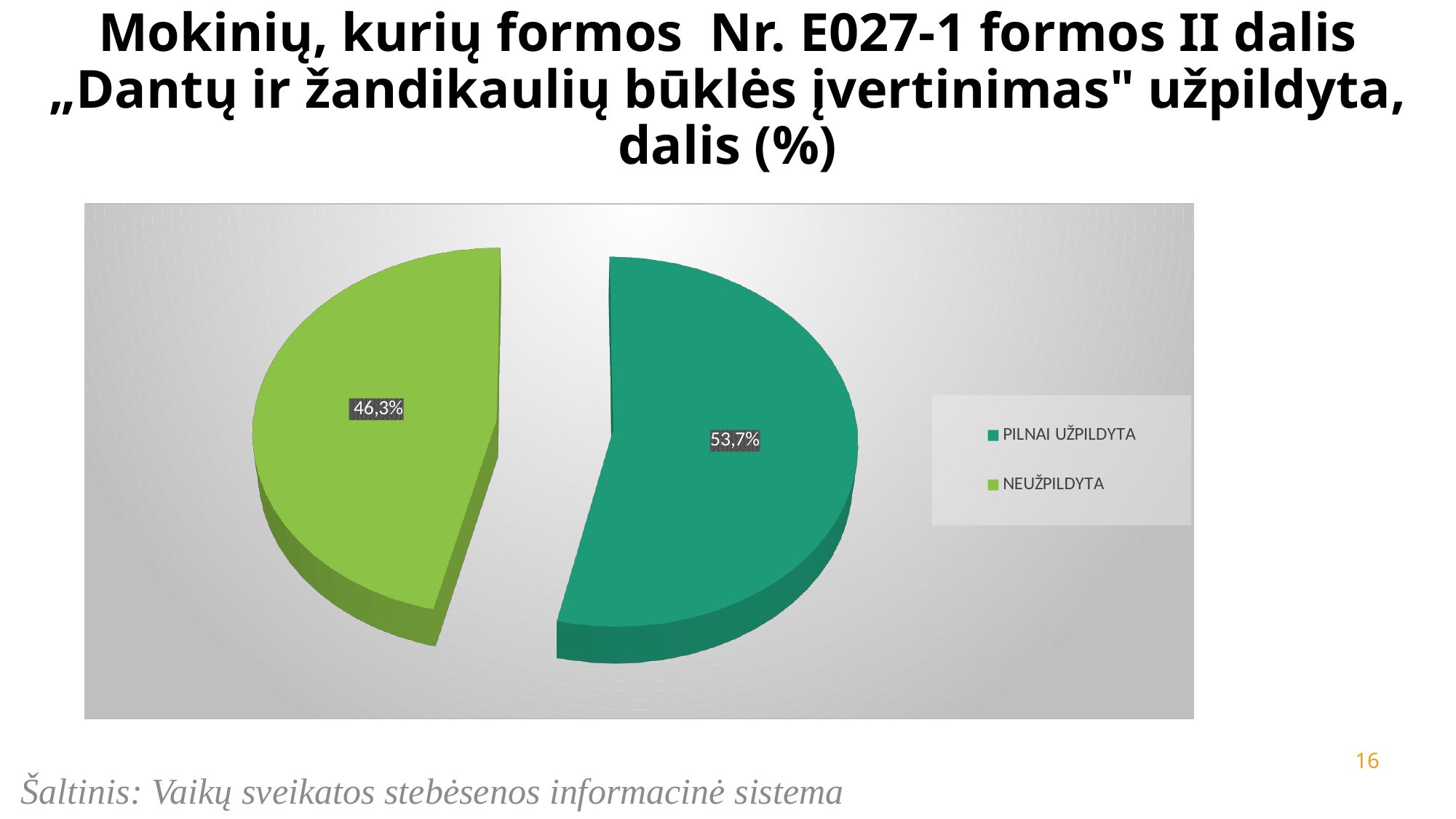
How many entries does the legend list? 2 Which slice is larger, PILNAI UŽPILDYTA or NEUŽPILDYTA? PILNAI UŽPILDYTA What is the difference in percentage points between the PILNAI UŽPILDYTA and NEUŽPILDYTA slices? 7,4 Which category has the largest slice of the pie? PILNAI UŽPILDYTA What share of the pie is labelled PILNAI UŽPILDYTA? 53,7% What share of the pie is labelled NEUŽPILDYTA? 46,3% Is the share for PILNAI UŽPILDYTA greater or less than 50%? greater How many slices does the pie chart have? 2 What kind of chart is shown on the slide? Pie chart What source is cited below the chart? Vaikų sveikatos stebėsenos informacinė sistema What colour is the NEUŽPILDYTA slice? Light green Which category has the smallest slice of the pie? NEUŽPILDYTA